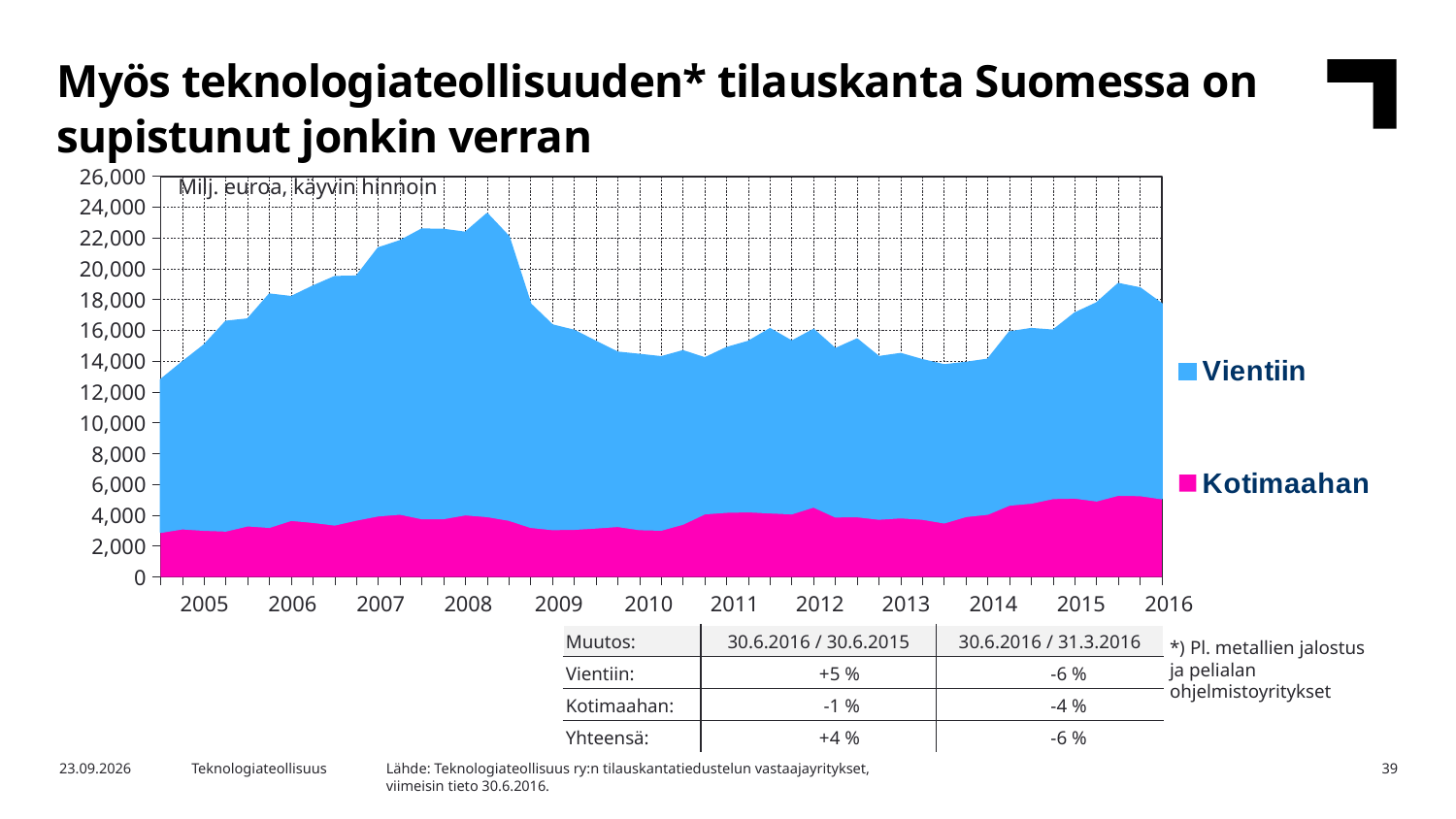
Is the total order stock at the end of the chart (2016) greater or less than 20,000? less Which series is larger throughout the chart, Vientiin or Kotimaahan? Vientiin What kind of chart is shown on the slide? Stacked area chart Is the total order stock at its 2008 peak greater or less than 22,000? greater What unit label is printed inside the chart area? Milj. euroa, käyvin hinnoin How many years are labelled on the x axis of the chart? 12 What are the two series named in the chart legend? Vientiin and Kotimaahan Is the Kotimaahan value at the end of the chart (2016) greater or less than 4,000? greater How many series does the chart legend list? 2 Does the total order stock rise or fall between 2008 and 2009? fall Does the total order stock rise or fall between 2005 and 2008? rise